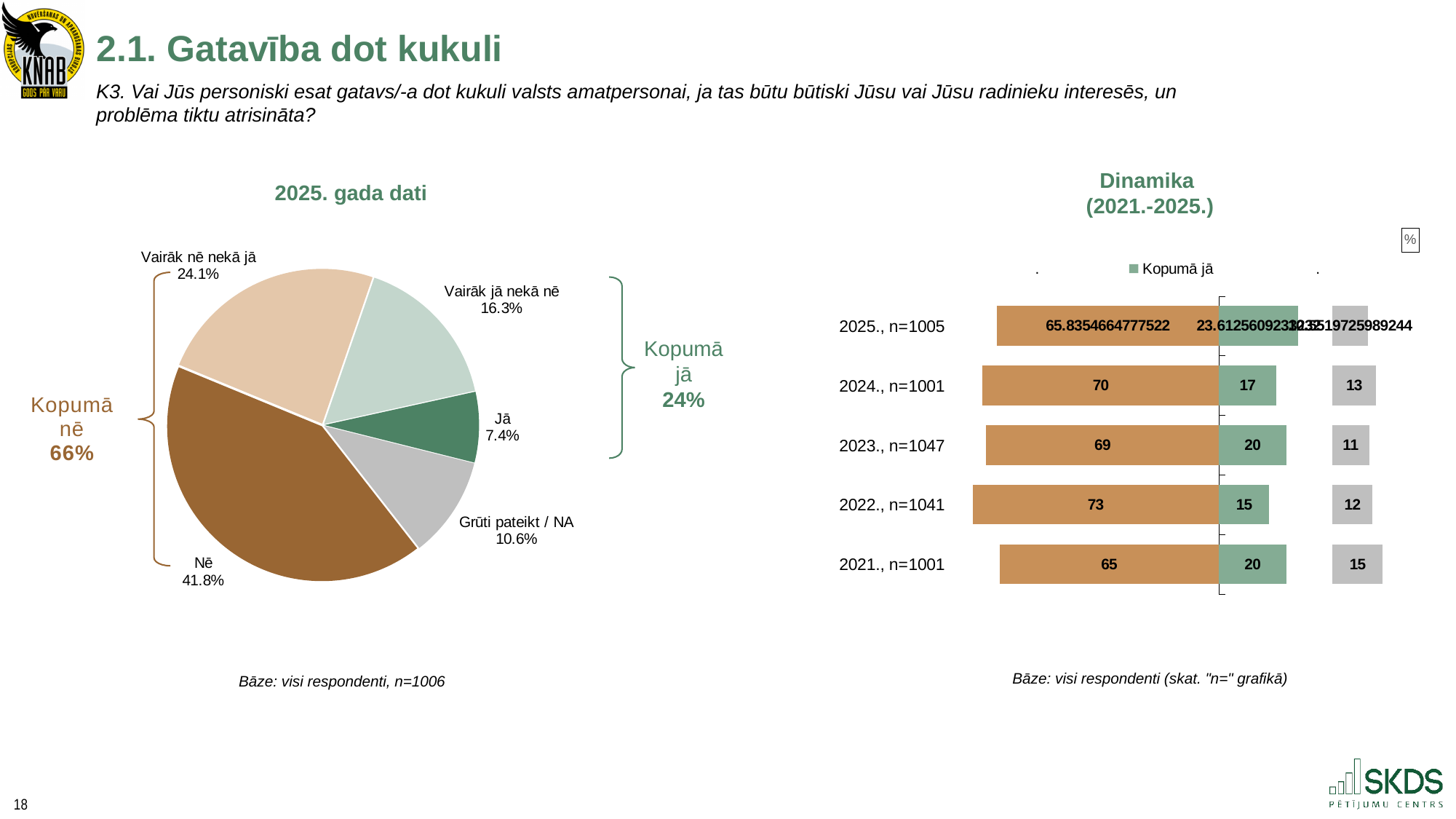
In the pie chart titled "2025. gada dati", which category has the smallest slice? Jā In the pie chart titled "2025. gada dati", which category has the largest slice? Nē In the pie chart titled "2025. gada dati", what is the value for "Nē"? 41.8% In the chart titled "Dinamika (2021.-2025.)", what is the value of the brown bar for "2022., n=1041"? 73 In the pie chart titled "2025. gada dati", what is the value for "Jā"? 7.4% In the chart titled "Dinamika (2021.-2025.)", which is larger: the green bar for "2024., n=1001" or the green bar for "2021., n=1001"? 2021., n=1001 In the chart titled "Dinamika (2021.-2025.)", what is the value of the green bar for "2023., n=1047"? 20 In the pie chart titled "2025. gada dati", how many slices are there? 5 In the chart titled "Dinamika (2021.-2025.)", what is the value of the grey bar for "2021., n=1001"? 15 In the pie chart titled "2025. gada dati", what is the difference between "Vairāk nē nekā jā" and "Vairāk jā nekā nē"? 7.8% What kind of chart is the one titled "Dinamika (2021.-2025.)"? bar chart What kind of chart is the one titled "2025. gada dati"? pie chart